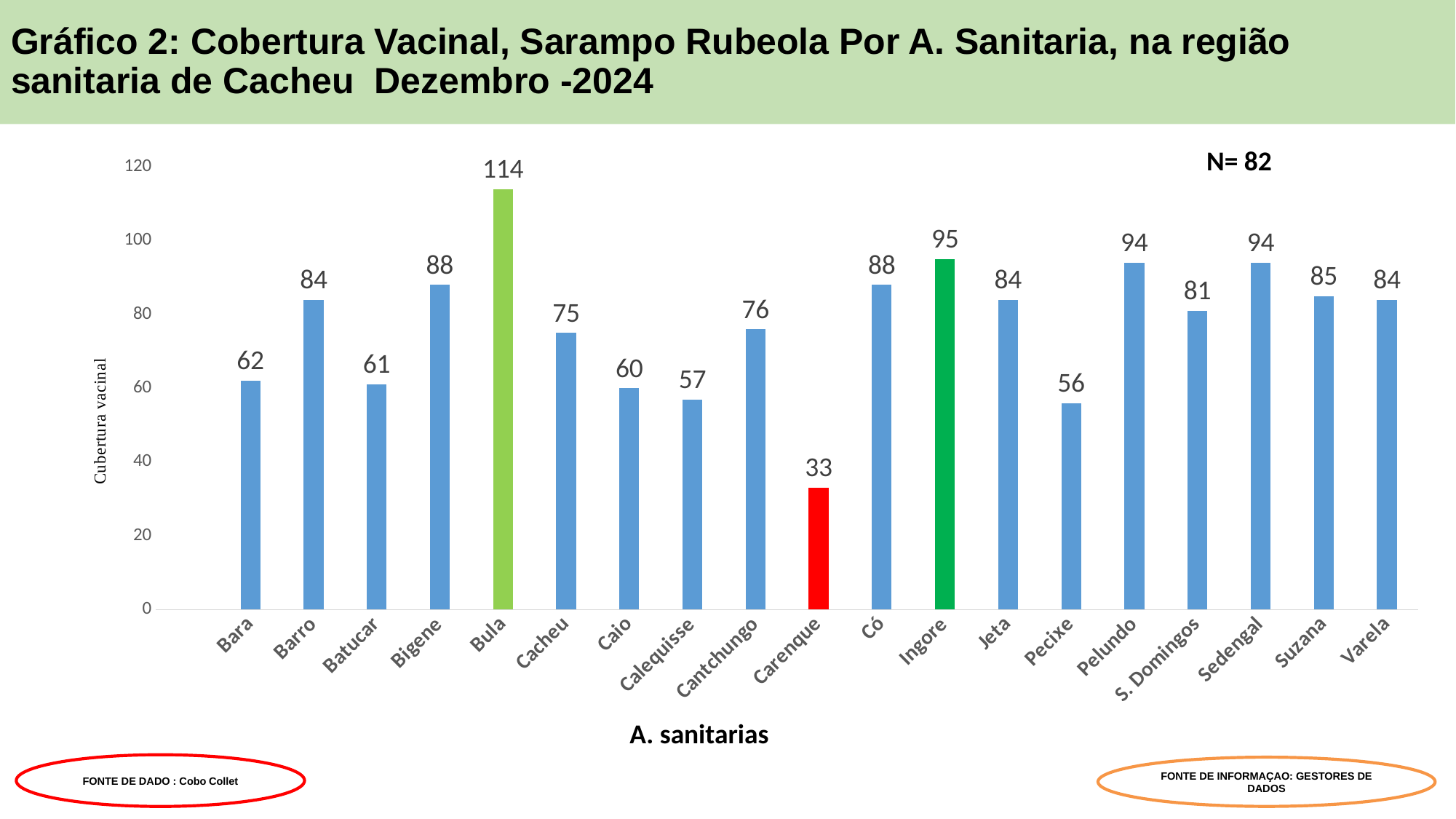
How many health areas are shown on the x axis? 19 What is the value shown for Carenque? 33 What type of chart is shown on the slide? Bar chart Which health area (A. sanitaria) has the highest vaccination coverage? Bula Which health area has the lowest vaccination coverage? Carenque What colour is the bar for Carenque? Red What is the difference between the values for Pelundo and Pecixe? 38 What is the vaccination coverage value for Bula? 114 What is the value shown for S. Domingos? 81 What is the value shown for Ingore? 95 Which has a higher value, Cacheu or Cantchungo? Cantchungo What is the difference between the values for Bula and Carenque? 81